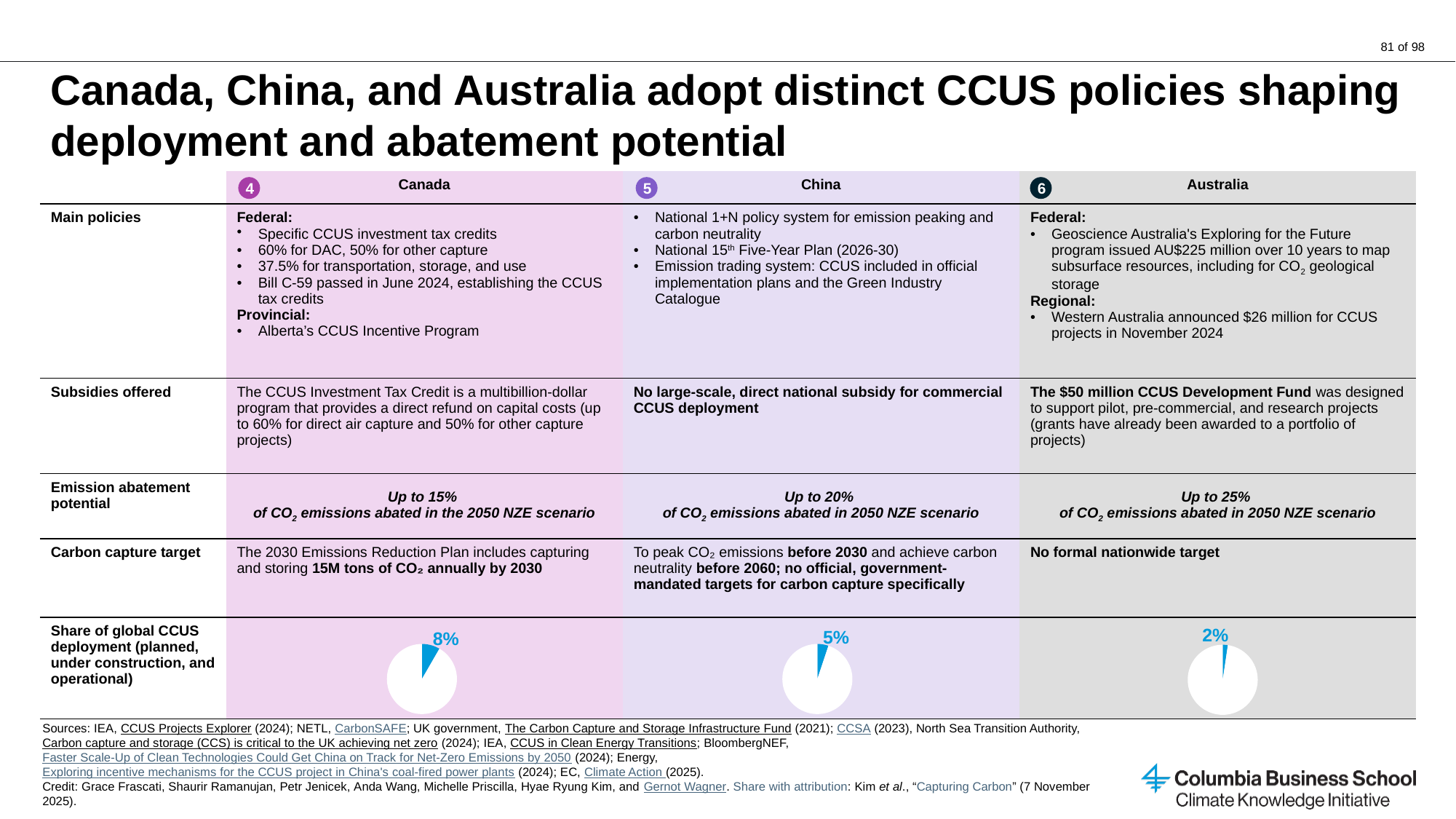
Based on the pie charts, how much larger is Canada's share of global CCUS deployment than China's? 3% Based on the pie charts, which has a larger share of global CCUS deployment, China or Australia? China In the Australia pie chart in the 'Share of global CCUS deployment' row, what value is shown for the highlighted slice? 2% In the China pie chart in the 'Share of global CCUS deployment' row, what value is shown for the highlighted slice? 5% Based on the pie charts, what is the difference between Canada's and Australia's share of global CCUS deployment? 6% Among the three pie charts showing share of global CCUS deployment, which country has the lowest share? Australia How many pie charts are shown in the 'Share of global CCUS deployment' row? 3 Among the three pie charts showing share of global CCUS deployment, which country has the highest share? Canada What kind of chart is used to show the share of global CCUS deployment for each country? Pie chart What colour is the highlighted slice in the pie charts showing share of global CCUS deployment? Blue In the Canada pie chart in the 'Share of global CCUS deployment' row, what value is shown for the highlighted slice? 8% Based on the pie charts, what is the difference between China's and Australia's share of global CCUS deployment? 3%